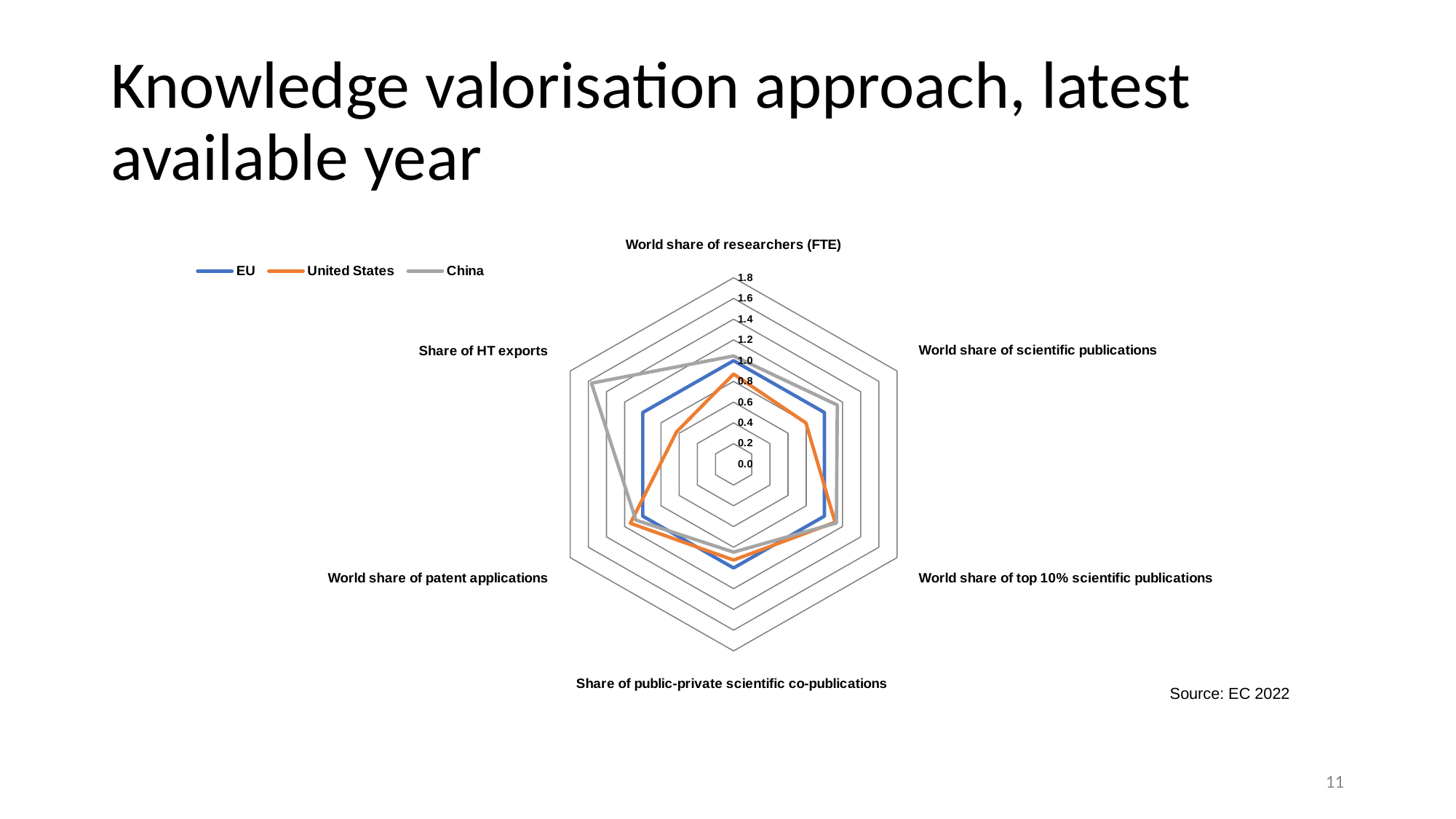
For Share of HT exports, which is larger: the EU or the United States? EU How many series does the legend list? 3 How many indicator axes (categories) does the radar chart have? 6 Which series is drawn in orange? United States On which indicator does China reach its highest value? Share of HT exports Is China's value for Share of HT exports greater or less than 1.2? greater Is the United States' value for World share of researchers (FTE) greater or less than 1.0? less Is the United States' value for Share of HT exports greater or less than 1.0? less For Share of HT exports, which is larger: China or the EU? China What kind of chart is shown on the slide? Radar chart For World share of scientific publications, which is larger: the EU or the United States? EU What is the maximum value shown on the radar chart's scale? 1.8